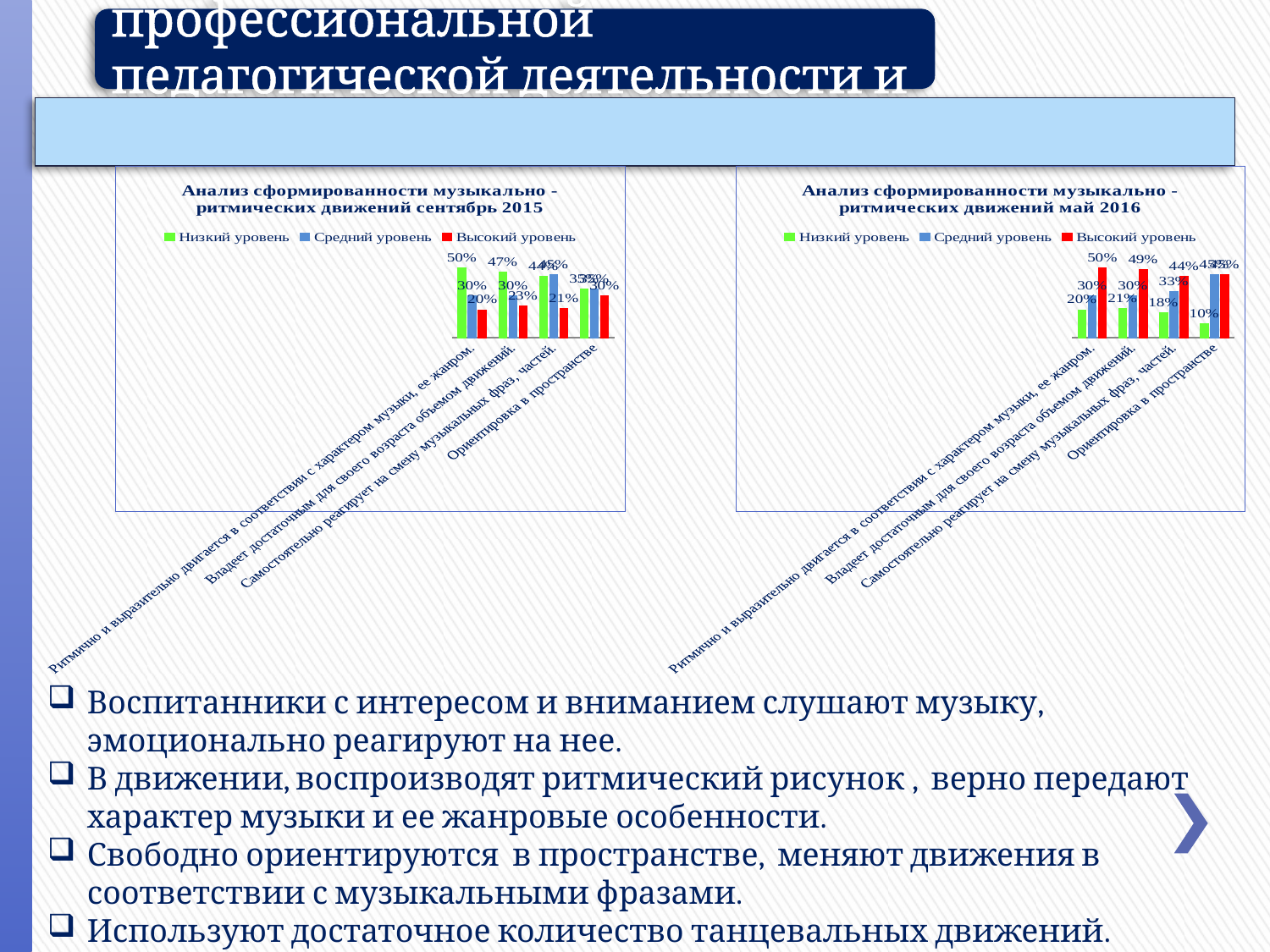
How many categories are shown on the x axis of the left chart ('сентябрь 2015')? 4 In the left chart ('сентябрь 2015'), what is the value of 'Высокий уровень' for 'Самостоятельно реагирует на смену музыкальных фраз, частей.'? 21% In the right chart ('май 2016'), what is the value of 'Средний уровень' for 'Самостоятельно реагирует на смену музыкальных фраз, частей.'? 33% In the right chart ('май 2016'), what is the value of 'Низкий уровень' for 'Ориентировка в пространстве'? 10% In the left chart ('сентябрь 2015'), do the 'Низкий уровень' values rise or fall from left to right along the x axis? fall In the right chart ('май 2016'), what is the difference between 'Высокий уровень' and 'Низкий уровень' for 'Ритмично и выразительно двигается в соответствии с характером музыки, ее жанром.'? 30 percentage points In the left chart ('сентябрь 2015'), which category has the highest 'Низкий уровень' value? Ритмично и выразительно двигается в соответствии с характером музыки, ее жанром. In the right chart ('май 2016'), what is the value of 'Высокий уровень' for 'Владеет достаточным для своего возраста объемом движений.'? 49% In the left chart ('сентябрь 2015'), what is the value of 'Низкий уровень' for 'Ритмично и выразительно двигается в соответствии с характером музыки, ее жанром.'? 50% What kind of chart is the left chart, 'Анализ сформированности музыкально-ритмических движений сентябрь 2015'? bar chart How many series does the legend of the right chart ('май 2016') list? 3 In the left chart ('сентябрь 2015'), what is the value of 'Высокий уровень' for 'Владеет достаточным для своего возраста объемом движений.'? 23%